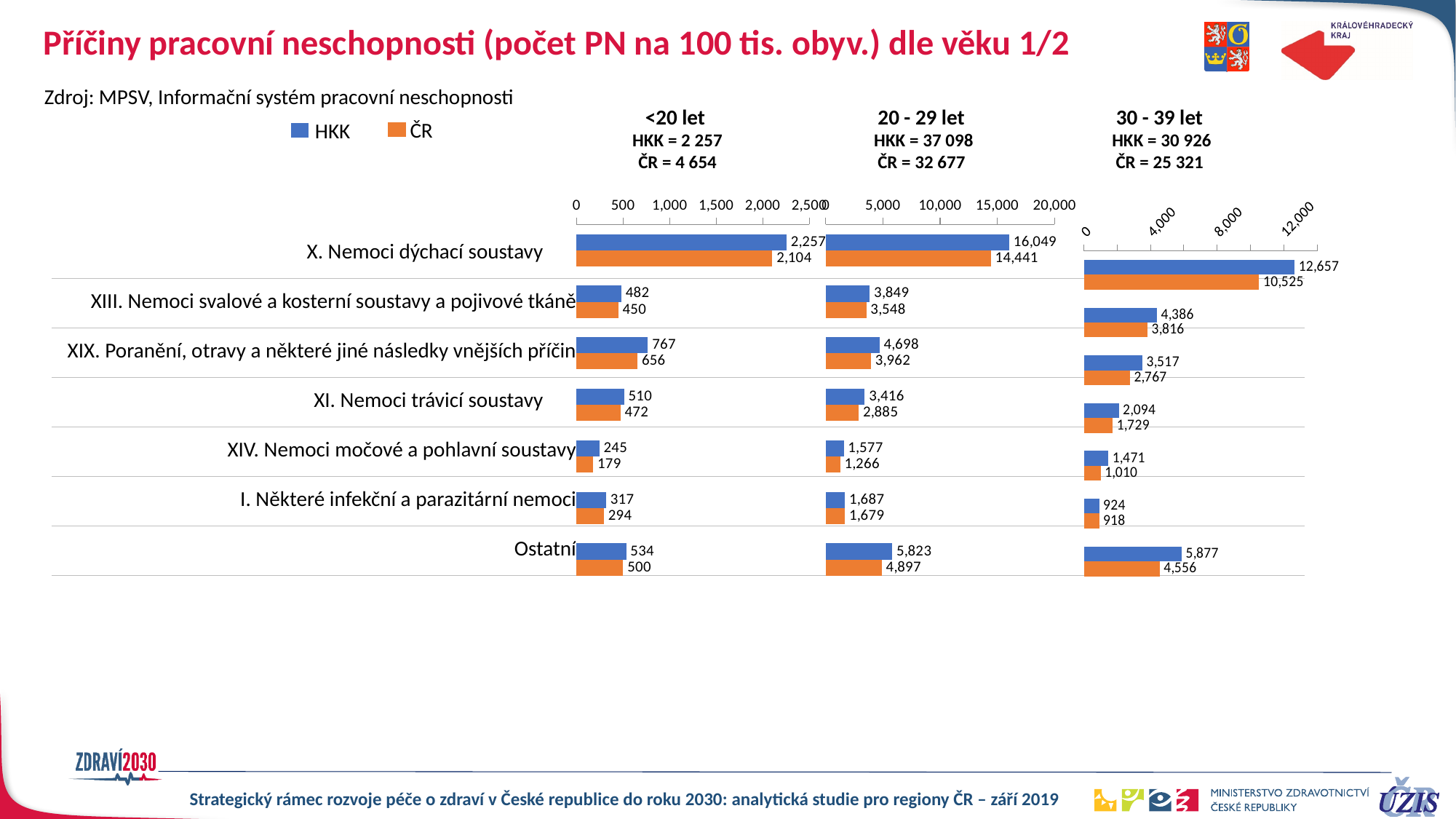
In the "20 - 29 let" chart, what is the difference between the HKK and ČR values for X. Nemoci dýchací soustavy? 1,608 How many series does the legend list? 2 In the "<20 let" chart, what is the HKK value for X. Nemoci dýchací soustavy? 2,257 In the "<20 let" chart, which category has the lowest ČR value? XIV. Nemoci močové a pohlavní soustavy What kind of chart is the "30 - 39 let" chart? Bar chart In the "30 - 39 let" chart, what is the HKK value for Ostatní? 5,877 In the "20 - 29 let" chart, is the HKK value for X. Nemoci dýchací soustavy greater or less than 15,000? greater In the "30 - 39 let" chart, which is larger for XIII. Nemoci svalové a kosterní soustavy a pojivové tkáně: HKK or ČR? HKK Which colour represents ČR in the legend? Orange How many categories are shown in the "<20 let" chart? 7 In the "30 - 39 let" chart, which category has the highest HKK value? X. Nemoci dýchací soustavy In the "20 - 29 let" chart, what is the ČR value for XIX. Poranění, otravy a některé jiné následky vnějších příčin? 3,962